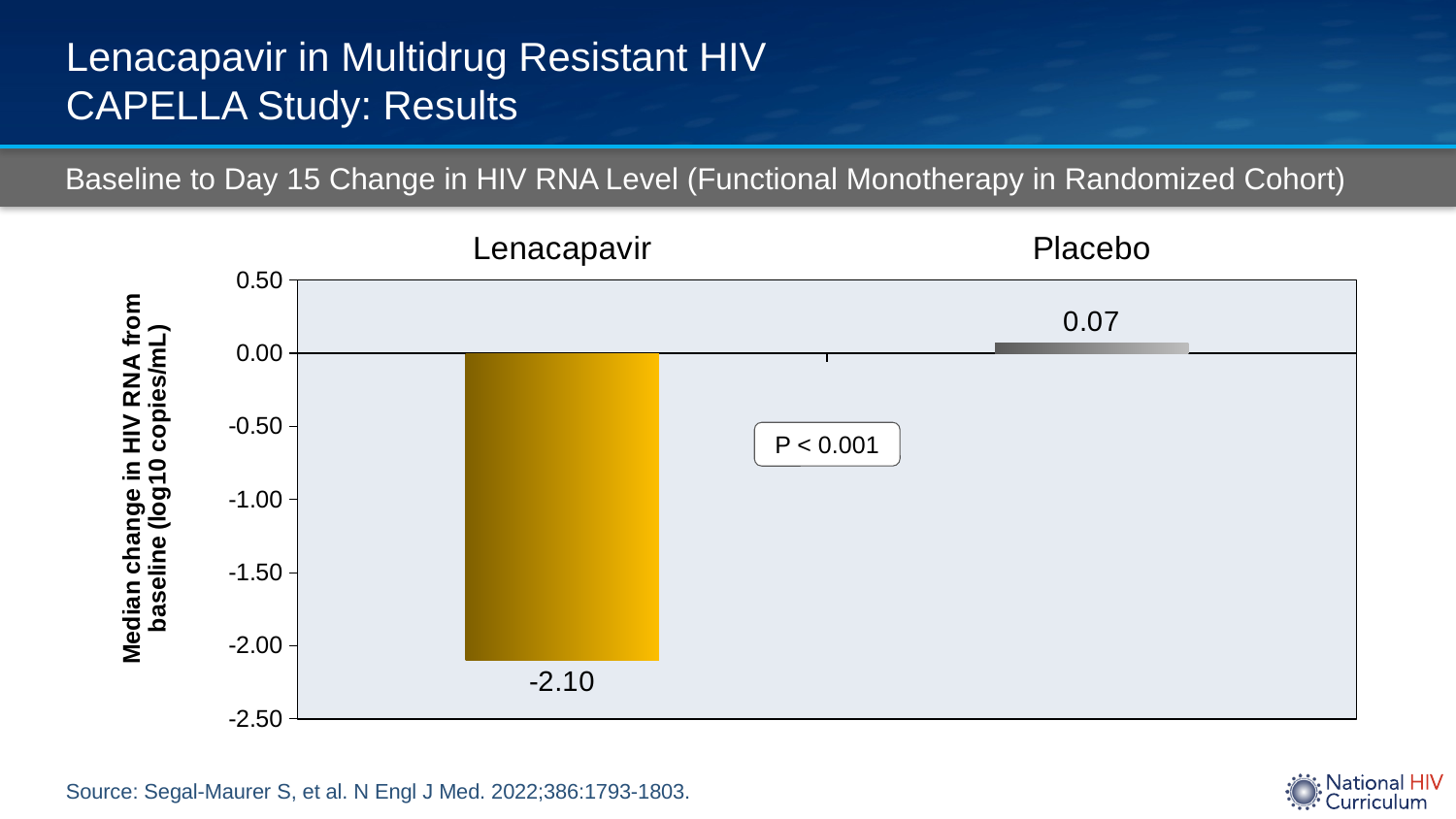
Which value is larger, Lenacapavir or Placebo? Placebo What is the label of the y axis? Median change in HIV RNA from baseline (log10 copies/mL) What is the difference between the Placebo value and the Lenacapavir value? 2.17 Which group has the lowest median change in HIV RNA from baseline? Lenacapavir Which group has the highest median change in HIV RNA from baseline? Placebo What is the median change in HIV RNA from baseline for Placebo? 0.07 What is the median change in HIV RNA from baseline for Lenacapavir? -2.10 What P value is shown on the chart? P < 0.001 Is the value for Placebo greater or less than 0.00? greater Is the value for Lenacapavir greater or less than -2.00? less How many groups are plotted in the chart? 2 What kind of chart is shown on the slide? Bar chart